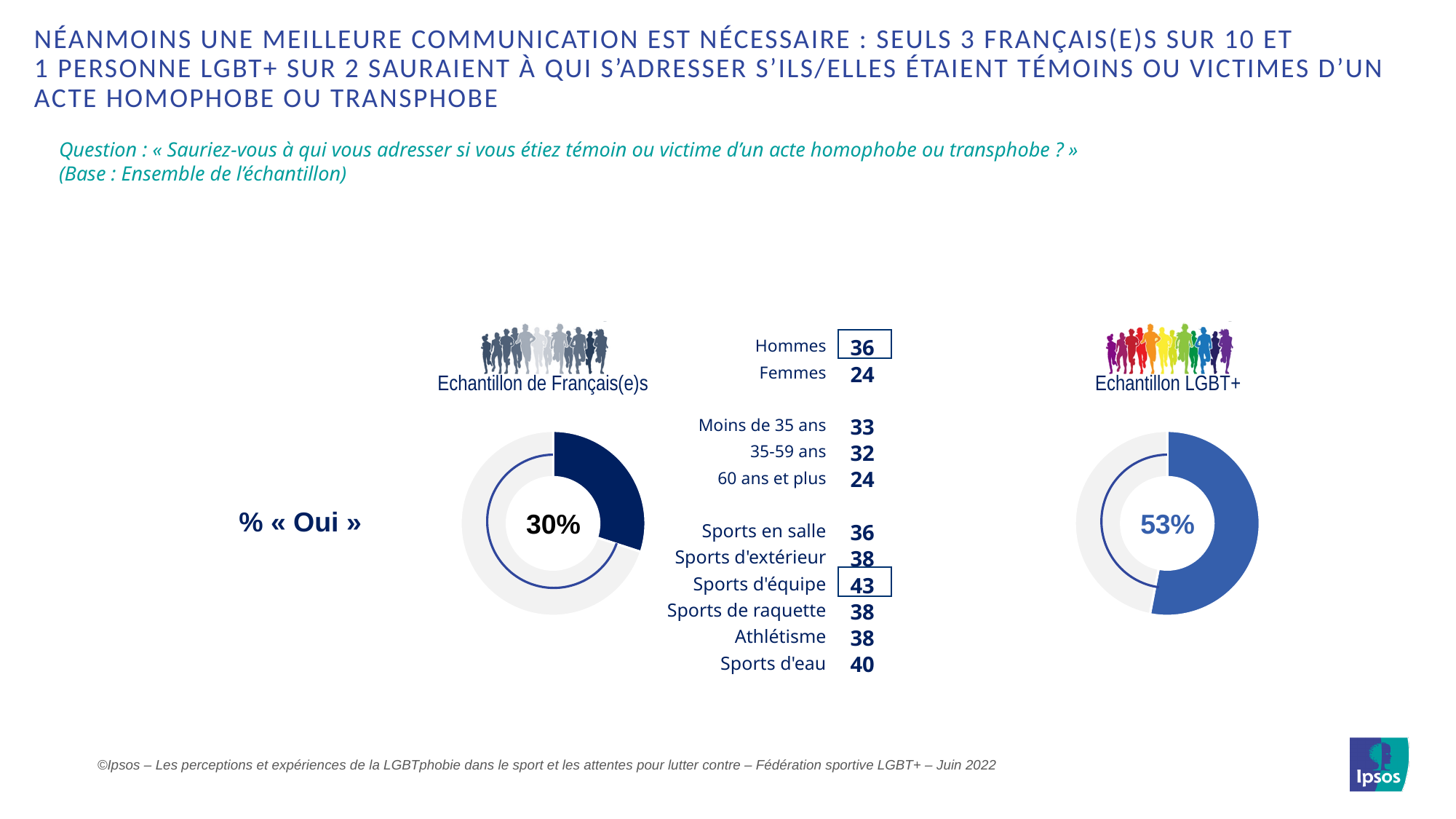
In the 'Echantillon de Français(e)s' donut chart, what percentage answered « Oui »? 30% Which sample has the higher share of « Oui » answers, 'Echantillon de Français(e)s' or 'Echantillon LGBT+'? Echantillon LGBT+ What is the title of the donut chart on the right of the slide? Echantillon LGBT+ What kind of chart is used to show the « Oui » share for each sample? Donut (pie) chart In the breakdown next to the 'Echantillon de Français(e)s' chart, what is the value for '60 ans et plus'? 24 Is the « Oui » share in the 'Echantillon LGBT+' donut chart greater or less than 50%? greater In the 'Echantillon LGBT+' donut chart, what percentage answered « Oui »? 53% In the breakdown next to the 'Echantillon de Français(e)s' chart, which sport category has the highest value? Sports d'équipe Is the « Oui » share in the 'Echantillon de Français(e)s' donut chart greater or less than 50%? less How many donut charts are shown on the slide? 2 What is the difference in percentage points between the « Oui » share in the 'Echantillon LGBT+' chart and the 'Echantillon de Français(e)s' chart? 23 In the breakdown next to the 'Echantillon de Français(e)s' chart, what is the value for 'Hommes'? 36